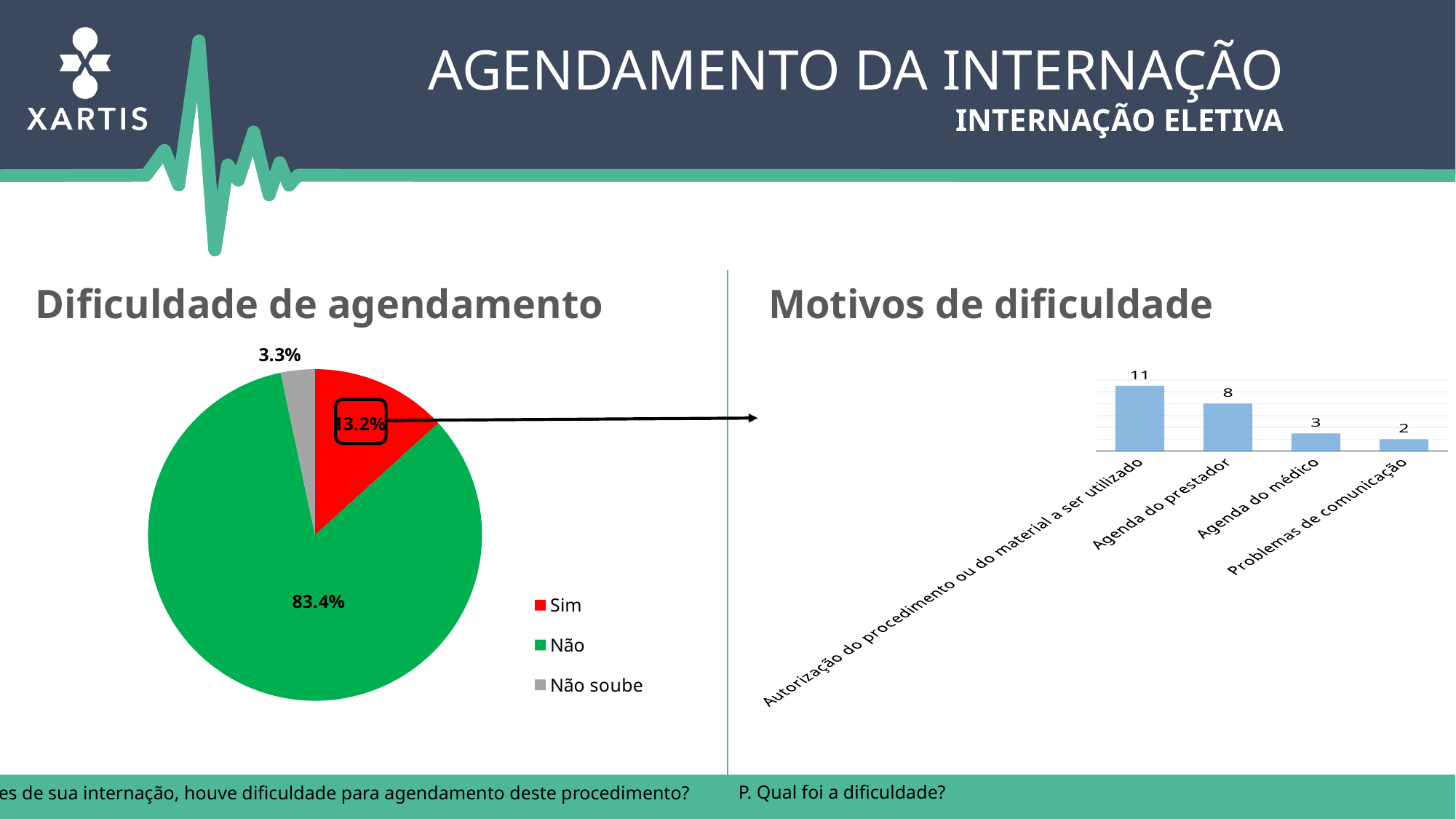
In the 'Dificuldade de agendamento' pie chart, what share is labelled for 'Sim'? 13.2% In the 'Dificuldade de agendamento' pie chart, how many categories does the legend list? 3 In the 'Motivos de dificuldade' chart, what is the difference between 'Agenda do prestador' and 'Agenda do médico'? 5 In the 'Dificuldade de agendamento' pie chart, which category has the largest slice? Não What type of chart is 'Motivos de dificuldade'? Bar chart In the 'Dificuldade de agendamento' pie chart, which category has the smallest slice? Não soube In the 'Dificuldade de agendamento' pie chart, what share is labelled for 'Não'? 83.4% In the 'Dificuldade de agendamento' pie chart, what share is labelled for 'Não soube'? 3.3% In the 'Motivos de dificuldade' chart, what is the value for 'Agenda do prestador'? 8 In the 'Motivos de dificuldade' chart, which category has the lowest value? Problemas de comunicação What type of chart is 'Dificuldade de agendamento'? Pie chart In the 'Motivos de dificuldade' chart, what is the value for 'Autorização do procedimento ou do material a ser utilizado'? 11